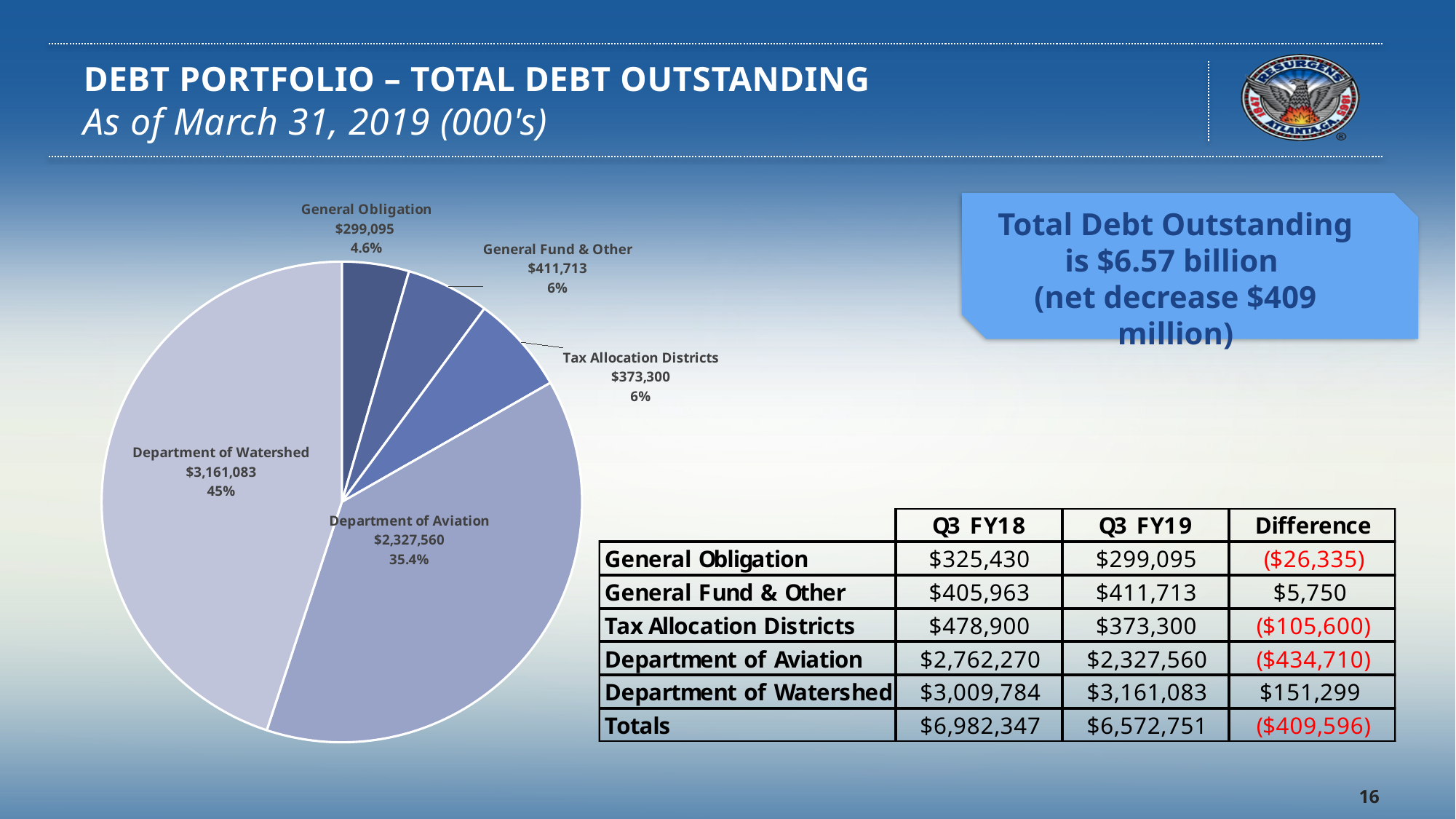
Which is larger in the pie chart, General Fund & Other or Tax Allocation Districts? General Fund & Other What is the value shown for Tax Allocation Districts in the pie chart? $373,300 What is the difference between the Department of Watershed and Department of Aviation values in the pie chart? $833,523 Which category has the largest slice in the pie chart? Department of Watershed What is the value shown for General Fund & Other in the pie chart? $411,713 What percentage share does the pie chart show for Department of Aviation? 35.4% How many slices does the pie chart have? 5 What is the value shown for Department of Watershed in the pie chart? $3,161,083 What is the difference between the General Fund & Other and Tax Allocation Districts values in the pie chart? $38,413 What kind of chart is shown on the slide? Pie chart Which category has the smallest slice in the pie chart? General Obligation What percentage share does the pie chart show for General Obligation? 4.6%